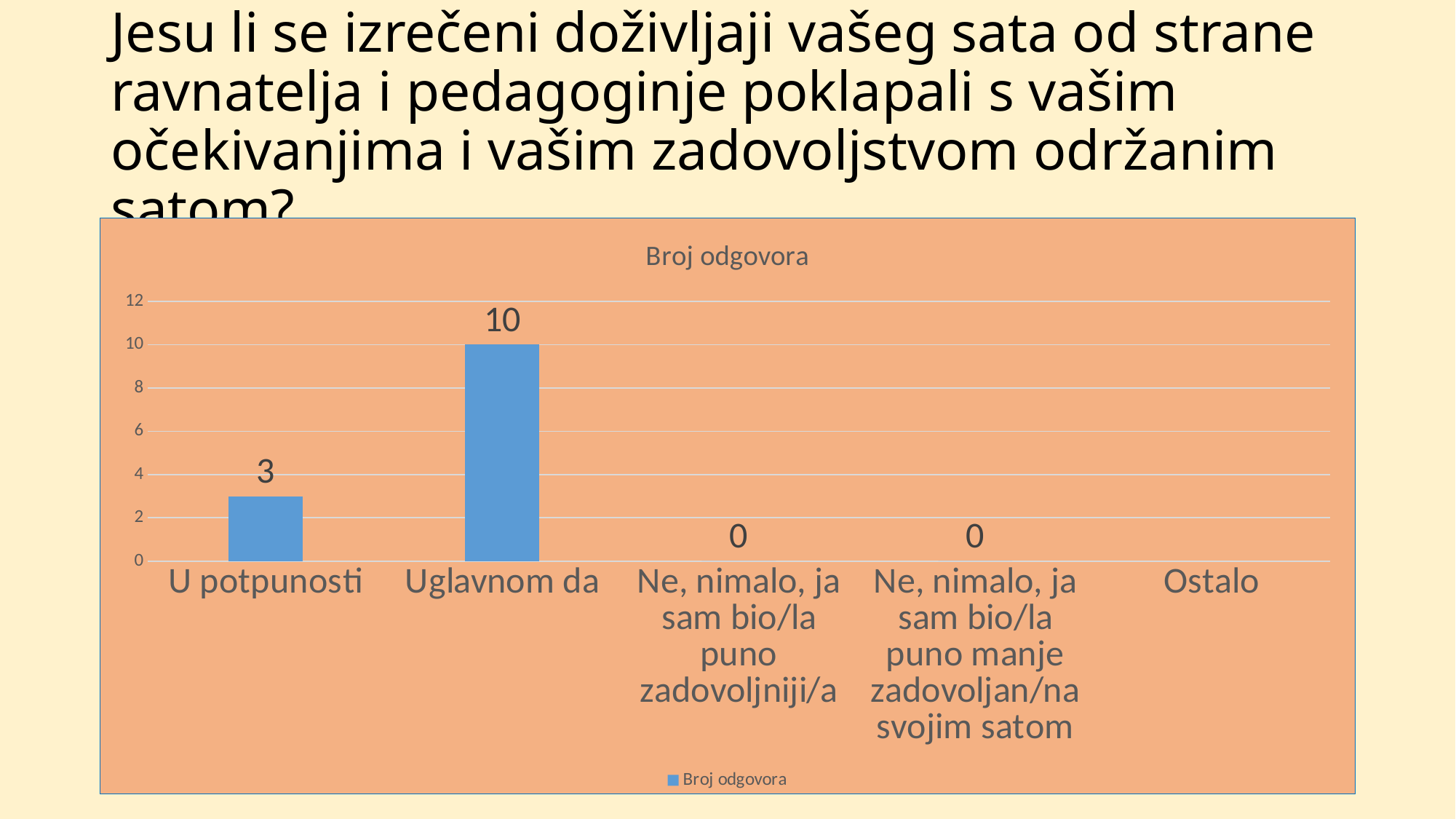
Is the value for "Uglavnom da" greater or less than 8? greater How many series does the legend list? 1 What kind of chart is shown on the slide? bar chart What is the value for "Ne, nimalo, ja sam bio/la puno manje zadovoljan/na svojim satom"? 0 What is the difference between the values for "Uglavnom da" and "U potpunosti"? 7 What is the value for "Ne, nimalo, ja sam bio/la puno zadovoljniji/a"? 0 What is the title of the chart? Broj odgovora Which is larger, the value for "U potpunosti" or the value for "Uglavnom da"? Uglavnom da What is the value for "Uglavnom da"? 10 What is the value for "U potpunosti"? 3 Which category has the highest value? Uglavnom da How many categories are shown on the x axis? 5